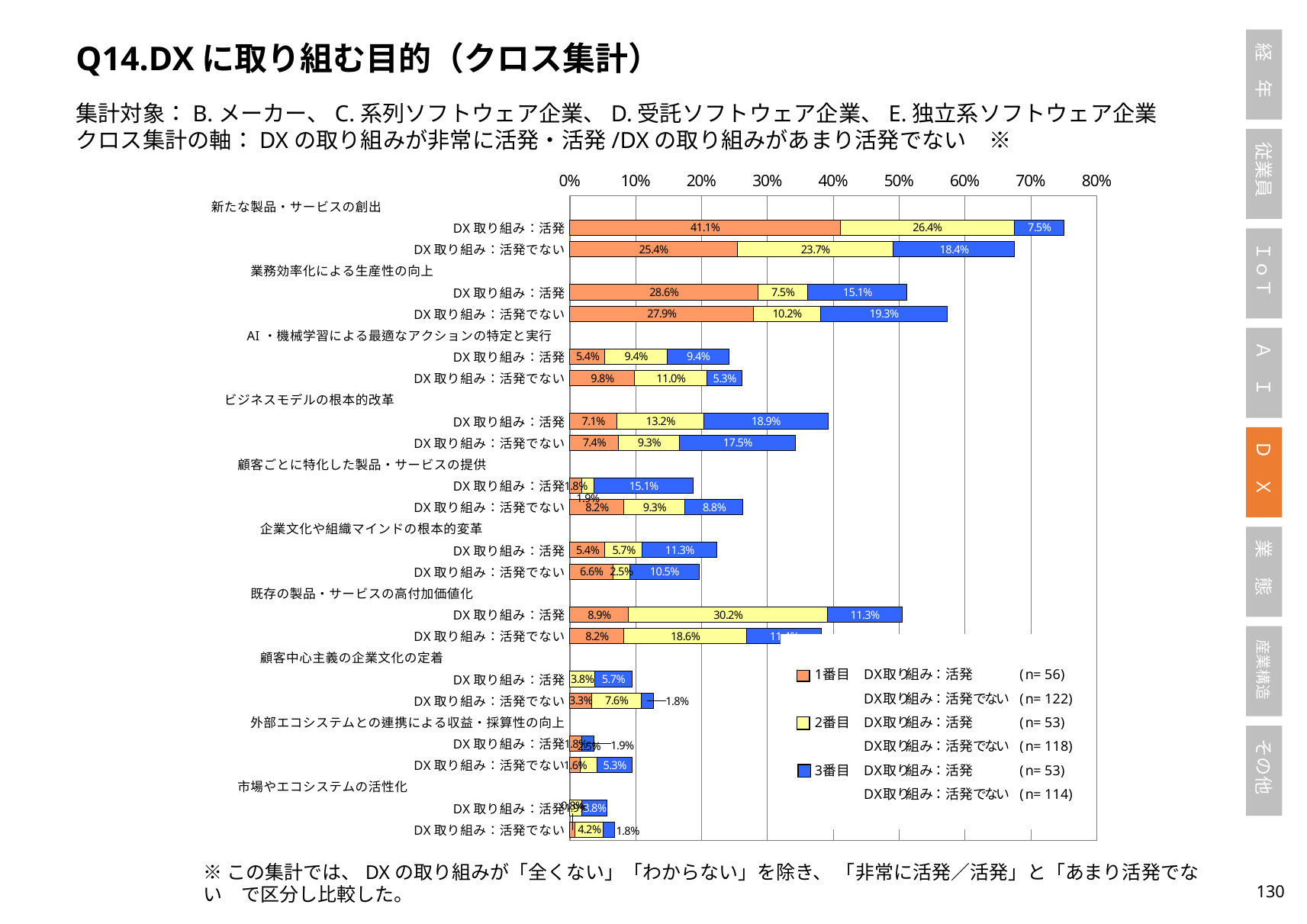
What is the total of the stacked bar for 新たな製品・サービスの創出, DX取り組み：活発? 75.0% How many series does the legend list? 3 What kind of chart is shown on the slide? bar chart What is the 1番目 value for 新たな製品・サービスの創出, DX取り組み：活発? 41.1% According to the legend, what is the n for 1番目 DX取り組み：活発? 56 What is the 3番目 value for 業務効率化による生産性の向上, DX取り組み：活発でない? 19.3% Which bar has the highest 1番目 value? 新たな製品・サービスの創出, DX取り組み：活発 What is the 2番目 value for 既存の製品・サービスの高付加価値化, DX取り組み：活発? 30.2% What is the 3番目 value for 新たな製品・サービスの創出, DX取り組み：活発でない? 18.4% What is the difference between the 1番目 values for 新たな製品・サービスの創出 between DX取り組み：活発 (41.1%) and DX取り組み：活発でない (25.4%)? 15.7 percentage points What is the total of the stacked bar for 新たな製品・サービスの創出, DX取り組み：活発でない? 67.5% For ビジネスモデルの根本的改革, which has the larger 3番目 value: DX取り組み：活発 or DX取り組み：活発でない? DX取り組み：活発